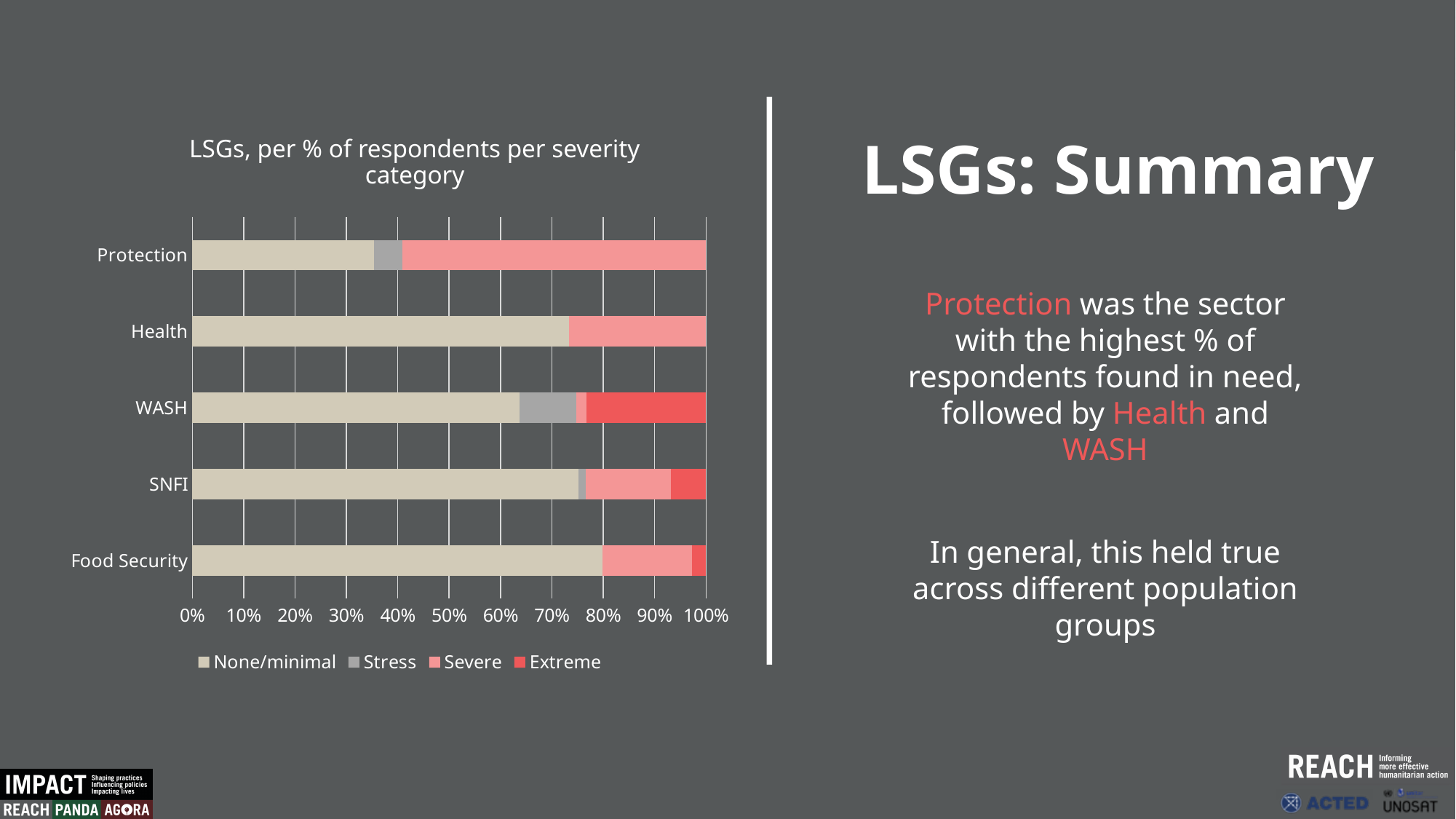
Which sector has the smallest None/minimal share? Protection Which has the larger None/minimal share, Protection or Health? Health How many sectors (categories) are plotted on the chart? 5 Which legend entry is shown in the darkest red colour? Extreme What is the title of the chart? LSGs, per % of respondents per severity category Is the None/minimal share for Protection greater or less than 40%? less Which sector has the largest None/minimal share? Food Security Is the None/minimal share for WASH greater or less than 60%? greater How many series does the chart legend list? 4 What kind of chart is shown on the slide? bar chart Is the None/minimal share for Health greater or less than 70%? greater Which sector has the largest Extreme share? WASH